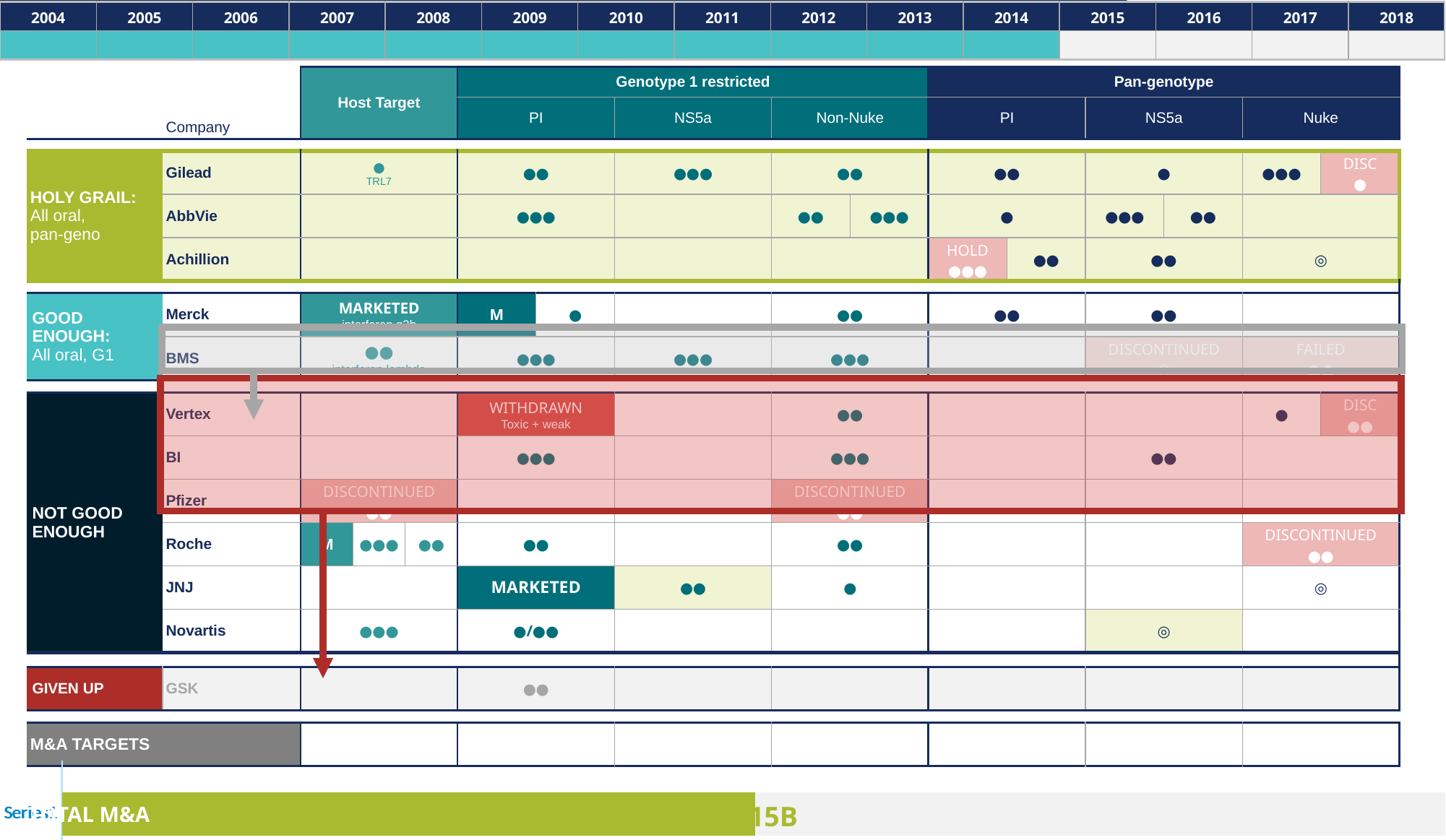
What colour is the TOTAL M&A bar at the bottom of the slide? green What kind of chart is shown at the bottom of the slide next to the label TOTAL M&A? bar chart What value label is printed at the end of the TOTAL M&A bar at the bottom of the slide? 15B How many series does the legend of the bottom chart list? 1 What is the series name shown in the legend of the bottom chart? Series1 How many bars does the chart at the bottom of the slide contain? 1